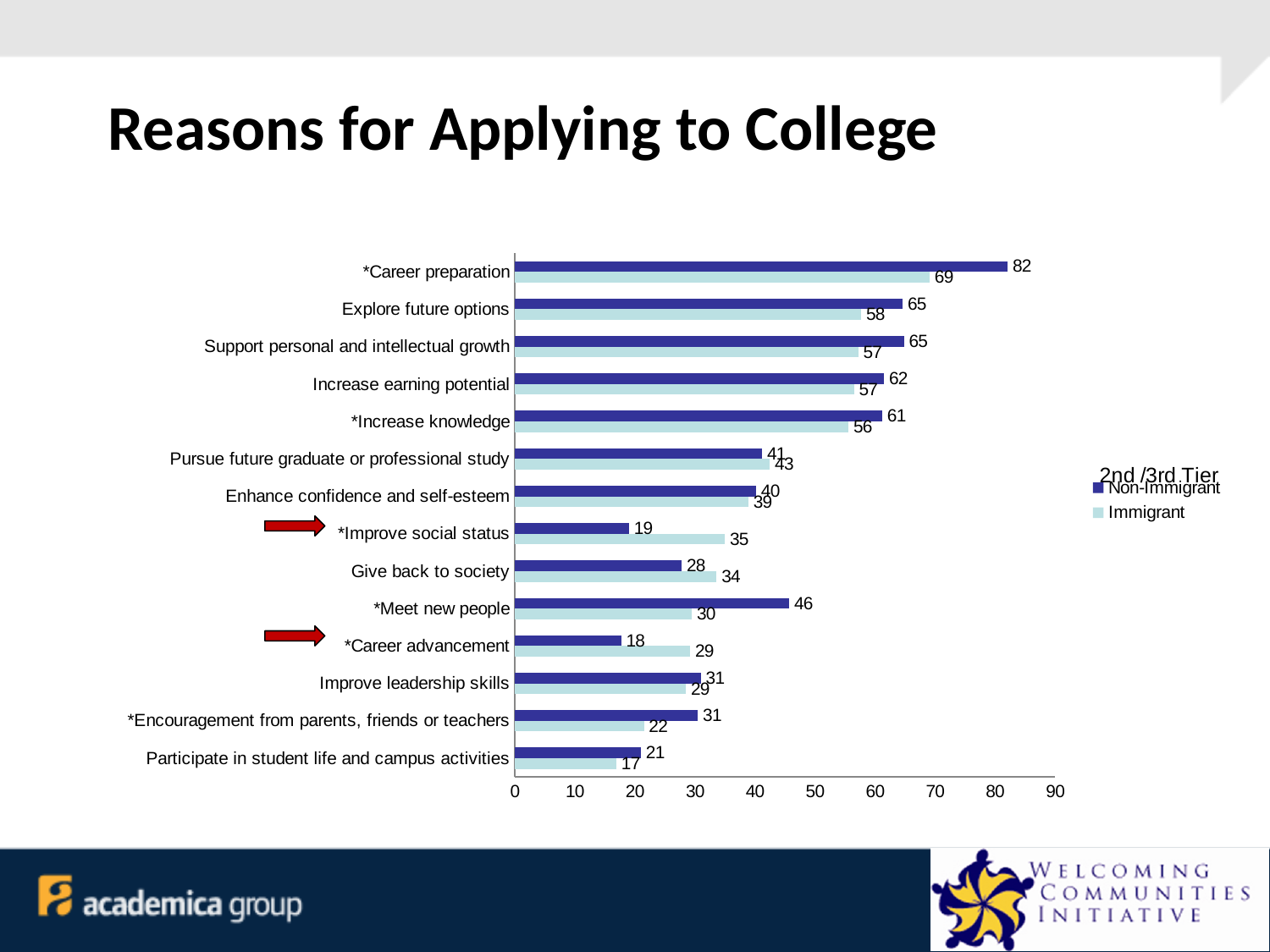
Which category has the lowest Immigrant value? Participate in student life and campus activities What is the Immigrant value for *Career advancement? 29 What is the Non-Immigrant value for *Career preparation? 82 Is the Non-Immigrant value for *Increase knowledge greater or less than 50? greater For *Improve social status, which is larger: the Non-Immigrant value or the Immigrant value? Immigrant What kind of chart is shown on the slide? Bar chart Which category has the highest Non-Immigrant value? *Career preparation How many series does the legend list? 2 What is the difference between the Non-Immigrant and Immigrant values for *Meet new people? 16 What is the title of the slide's chart? 2nd /3rd Tier How many categories are shown on the chart? 14 What is the Immigrant value for *Improve social status? 35